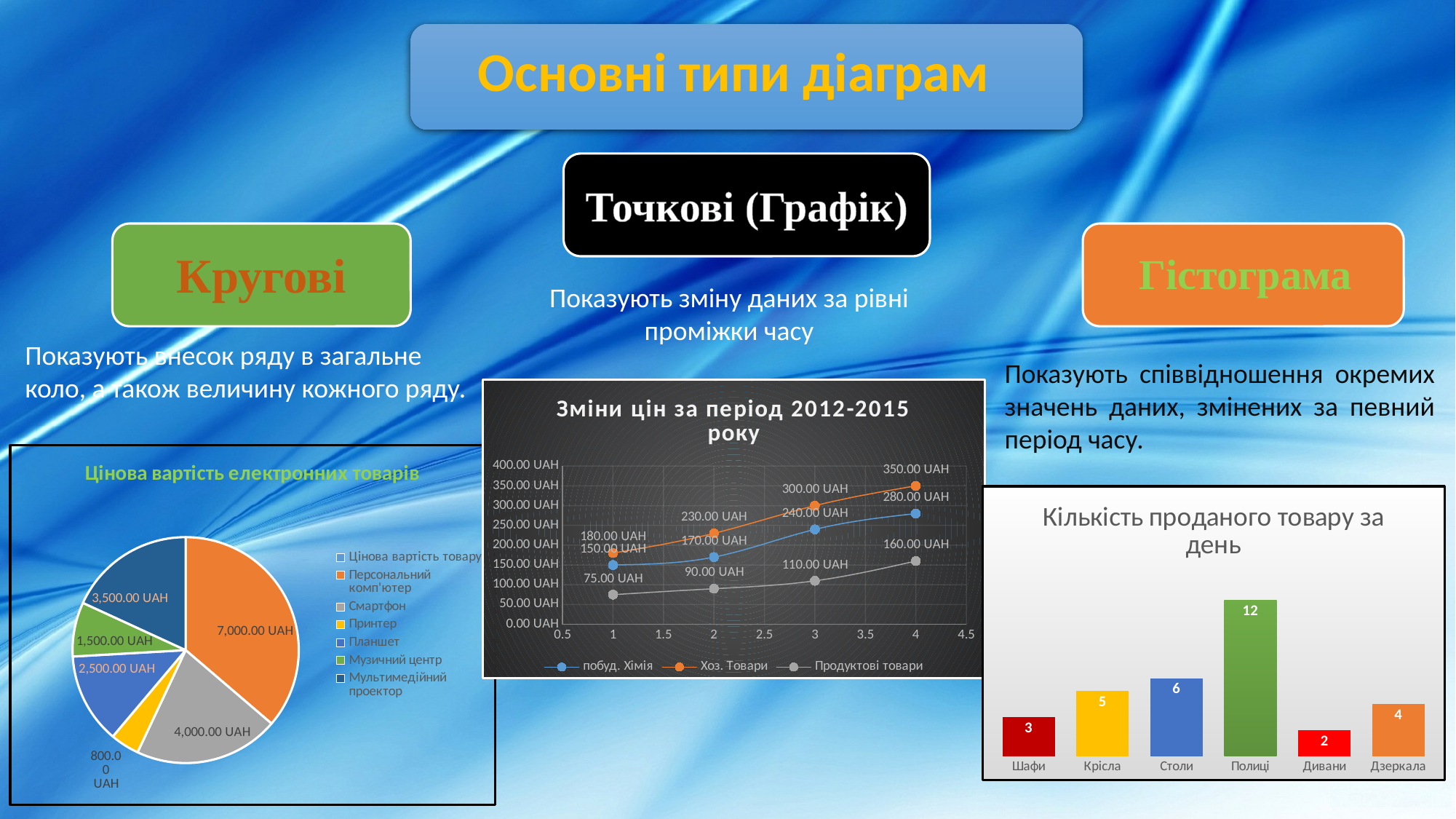
In the chart 'Кількість проданого товару за день', what is the value for Полиці? 12 In the chart 'Кількість проданого товару за день', which category has the lowest value? Дивани What type of chart is 'Кількість проданого товару за день'? bar chart In the pie chart 'Цінова вартість електронних товарів', what is the value of the Смартфон slice? 4,000.00 UAH In the chart 'Зміни цін за період 2012-2015 року', what is the value of the Продуктові товари series at x = 1? 75.00 UAH In the chart 'Зміни цін за період 2012-2015 року', do the values of the побуд. Хімія series rise or fall from x = 1 to x = 4? rise How many categories are shown in the chart 'Кількість проданого товару за день'? 6 In the chart 'Зміни цін за період 2012-2015 року', what is the value of the Хоз. Товари series at x = 3? 300.00 UAH In the chart 'Кількість проданого товару за день', what is the difference between the values for Столи and Шафи? 3 In the chart 'Зміни цін за період 2012-2015 року', what is the difference between the Хоз. Товари and побуд. Хімія values at x = 4? 70.00 UAH In the pie chart 'Цінова вартість електронних товарів', which slice is the largest? Персональний комп'ютер How many series does the legend of the chart 'Зміни цін за період 2012-2015 року' list? 3